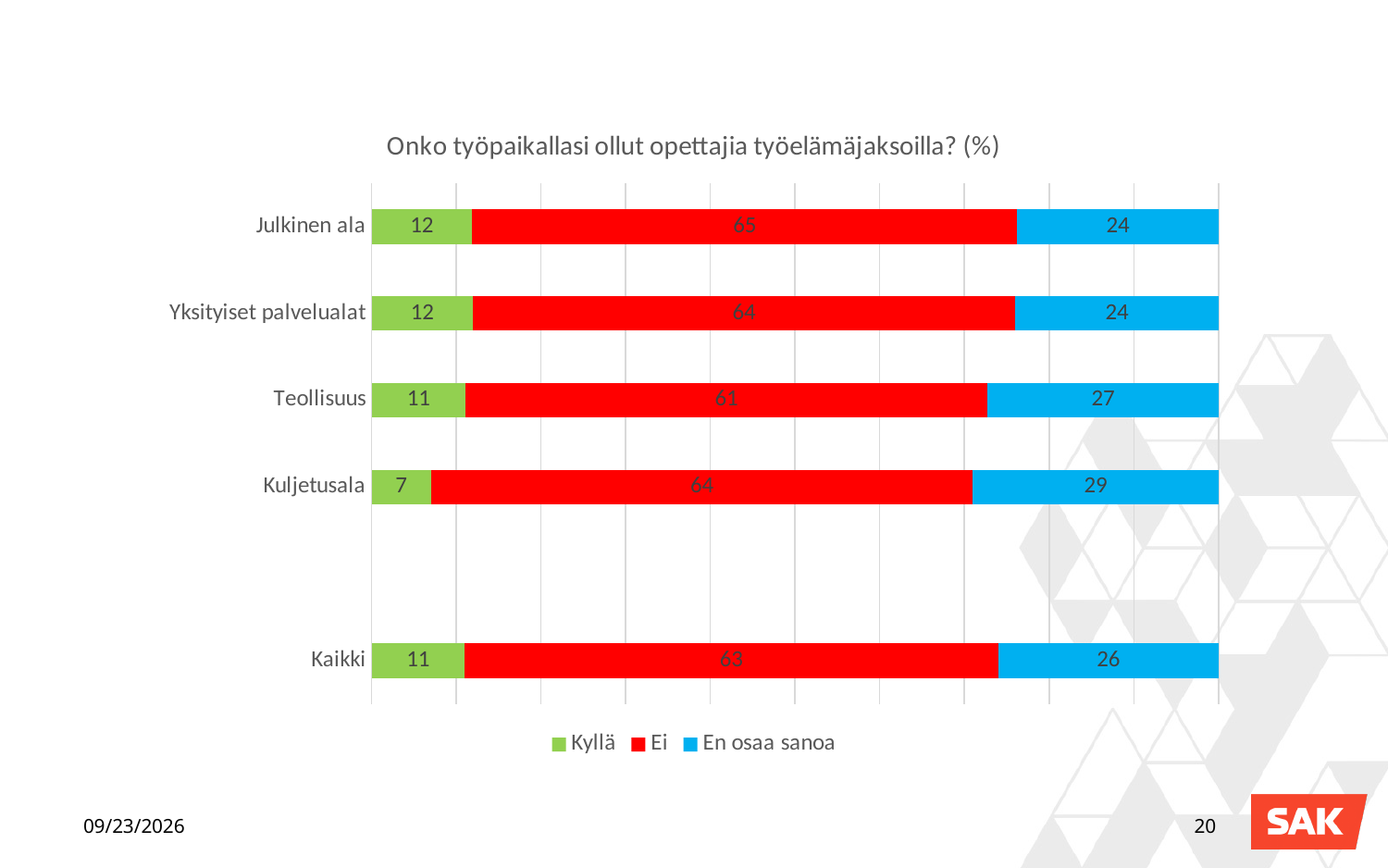
Which is larger, the Ei value for Teollisuus or the Ei value for Yksityiset palvelualat? Yksityiset palvelualat How many categories are shown on the chart? 5 How many series does the legend list? 3 What kind of chart is shown on the slide? Stacked bar chart What is the total of the stacked bar for Teollisuus? 99 What is the value for Ei in the Kaikki bar? 63 Which category has the lowest value for Kyllä? Kuljetusala What is the difference between the En osaa sanoa values for Kuljetusala and Julkinen ala? 5 What is the value for Ei in the Julkinen ala bar? 65 What is the value for Kyllä in the Kuljetusala bar? 7 What is the value for En osaa sanoa in the Teollisuus bar? 27 Which category has the highest value for En osaa sanoa? Kuljetusala